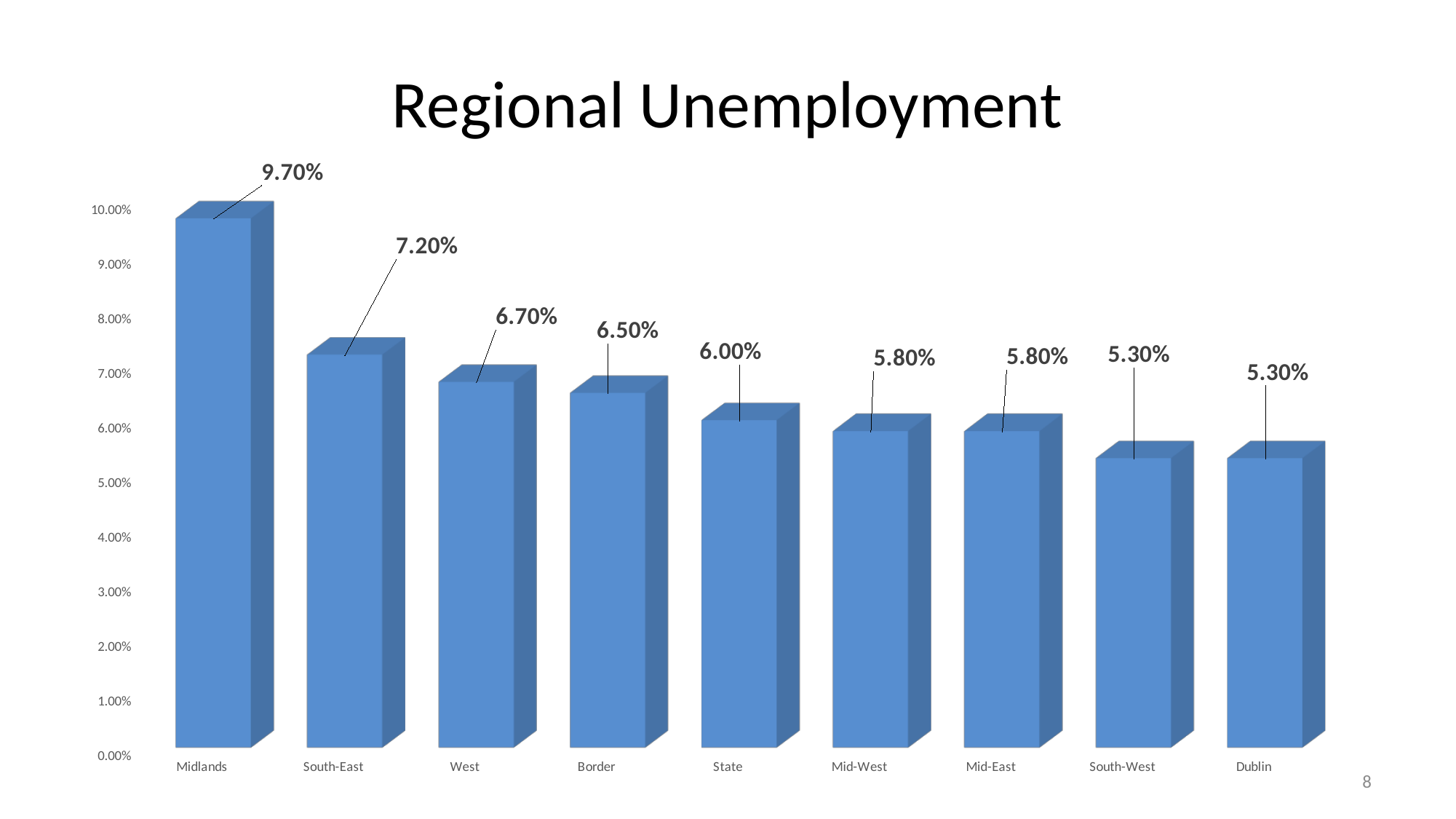
What is the unemployment rate shown for South-East? 7.20% What is the unemployment rate shown for Dublin? 5.30% Which has a higher unemployment rate, West or Border? West What is the difference between the Midlands and Dublin unemployment rates? 4.40% What is the unemployment rate shown for Midlands? 9.70% Which has a higher unemployment rate, State or Mid-West? State What is the value shown for State? 6.00% Do the values rise or fall from left to right across the chart? Fall What is the difference between the Midlands and South-East unemployment rates? 2.50% How many regions are shown on the chart? 9 What kind of chart is shown on the slide? Bar chart Which region has the highest unemployment rate? Midlands